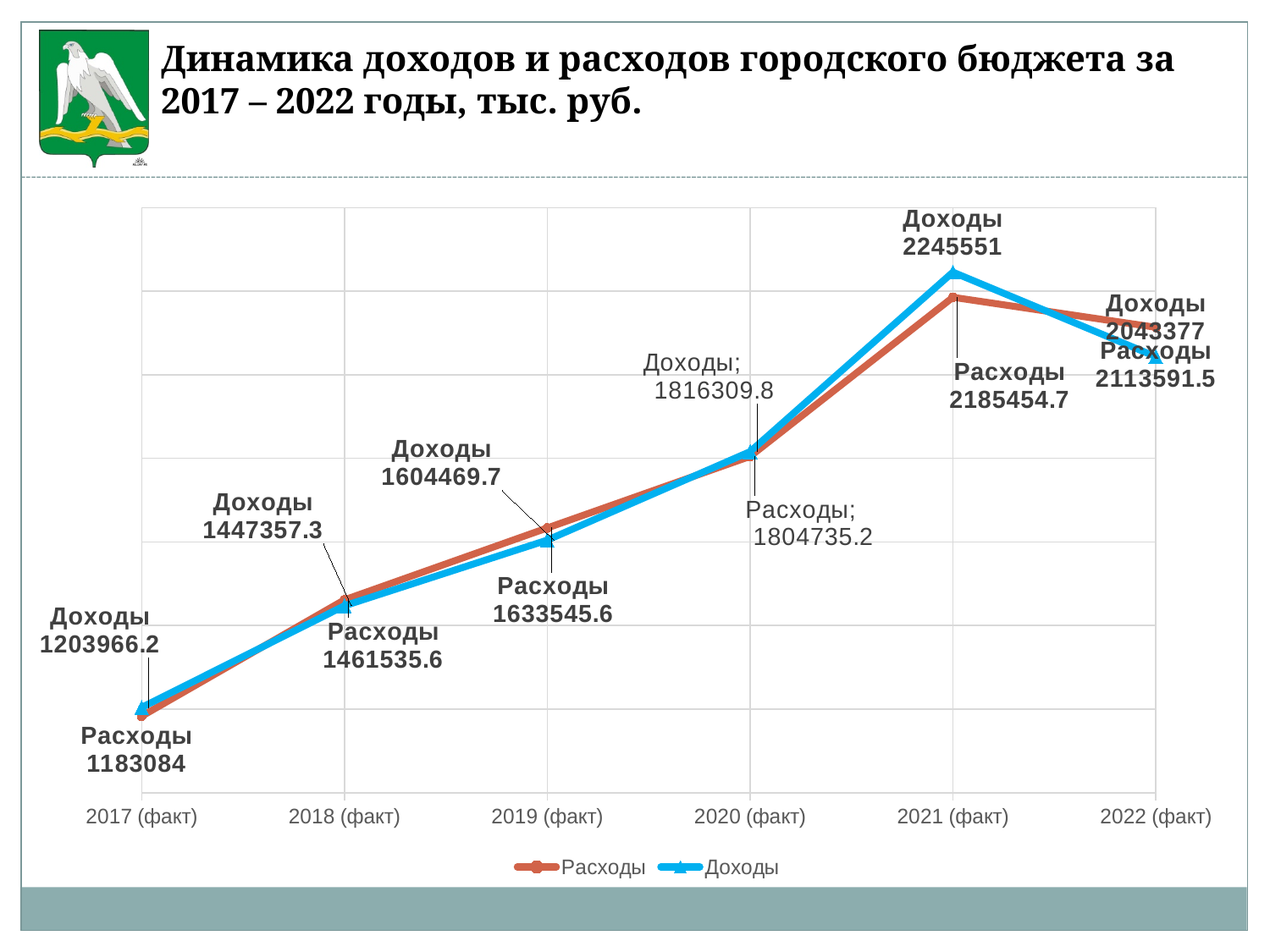
In which year is Доходы highest? 2021 (факт) What is the value of Доходы for 2017 (факт)? 1203966.2 Which is larger in 2018 (факт), Доходы or Расходы? Расходы What is the difference between Доходы and Расходы in 2021 (факт)? 60096.3 In which year is Расходы lowest? 2017 (факт) What is the value of Расходы for 2022 (факт)? 2113591.5 How many series does the legend list? 2 What is the value of Доходы for 2021 (факт)? 2245551 What kind of chart is shown on the slide? line chart What is the difference between Расходы and Доходы in 2022 (факт)? 70214.5 What is the value of Расходы for 2019 (факт)? 1633545.6 How many years are shown on the x axis? 6